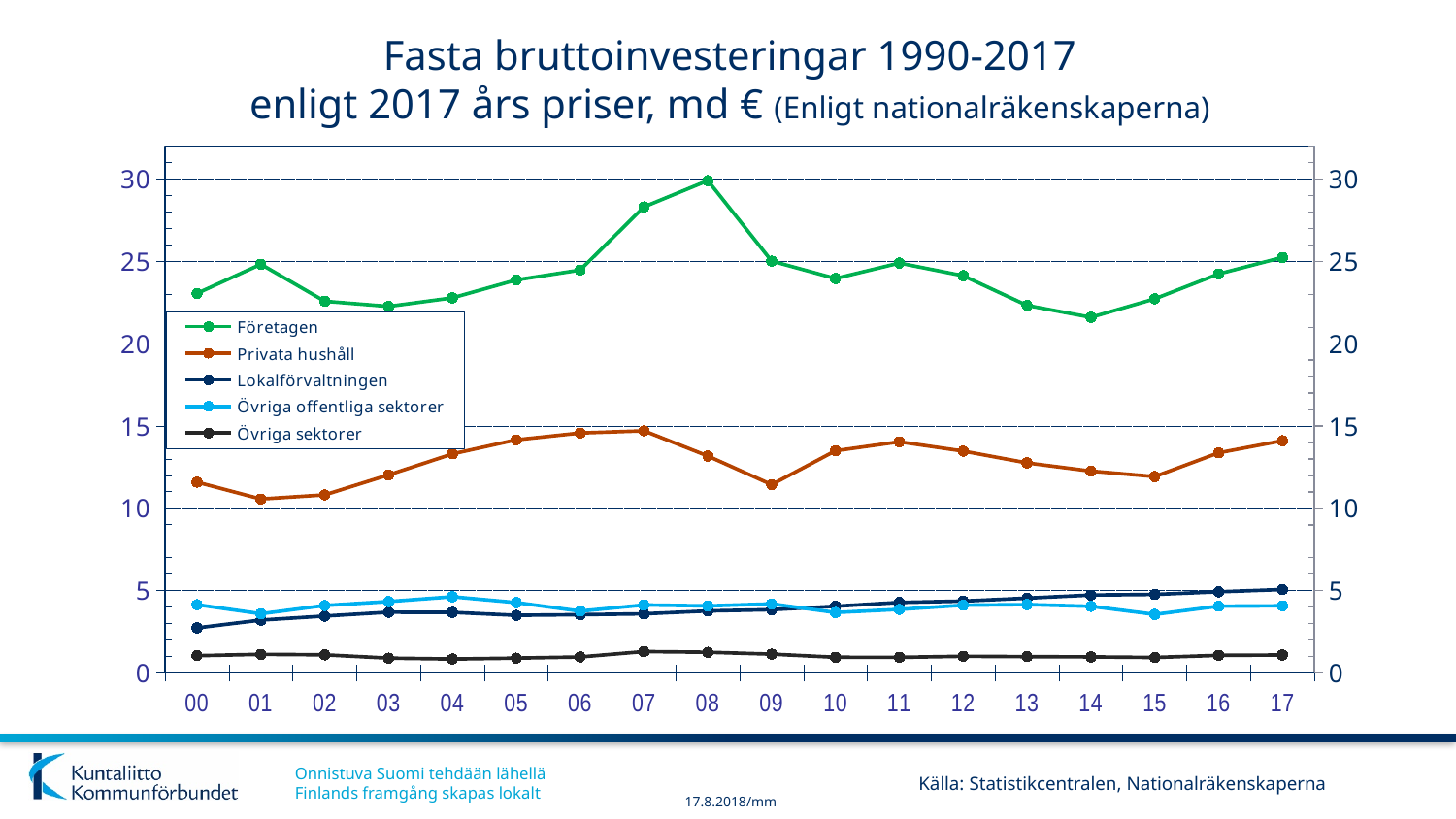
In which year does the Företagen series reach its lowest value? 14 Is the value for Privata hushåll in 09 greater or less than 15? less In which year does the Företagen series reach its highest value? 08 In 00, which is larger: Lokalförvaltningen or Övriga offentliga sektorer? Övriga offentliga sektorer Which series is drawn in green? Företagen How many series does the legend list? 5 How many years are plotted along the x axis? 18 What kind of chart is shown on the slide? line chart Is the value for Företagen in 08 greater or less than 25? greater In 08, which is larger: Företagen or Privata hushåll? Företagen Is the value for Övriga sektorer in 07 greater or less than 5? less Does the Lokalförvaltningen series generally rise or fall from 00 to 17? rise